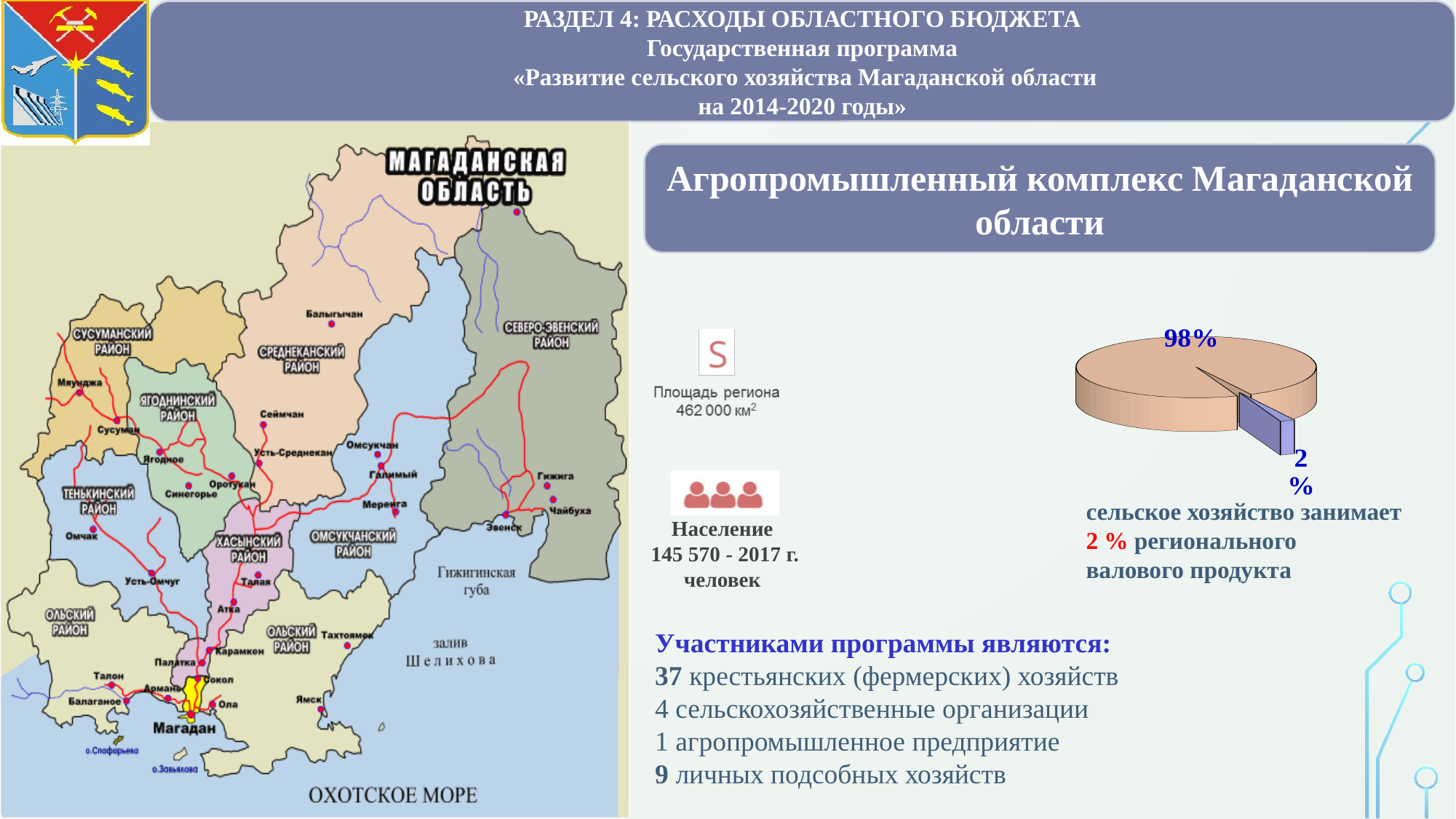
How many slices does the pie chart have? 2 What kind of chart is shown on the right side of the slide? pie chart What is the total of the two slice values shown on the pie chart? 100% Is the value of the large slice of the pie chart greater or less than 50%? greater What is the value of the largest slice of the pie chart? 98% What is the difference in percentage points between the two slices of the pie chart? 96 What colour is the slice representing 98% in the pie chart? tan (beige) What share of the regional gross product does agriculture occupy according to the pie chart? 2% Is the value of the small blue slice of the pie chart greater or less than 50%? less What is the value of the smallest slice of the pie chart? 2% What colour is the slice representing 2% in the pie chart? blue Which slice of the pie chart is larger, the 98% slice or the 2% slice? 98%